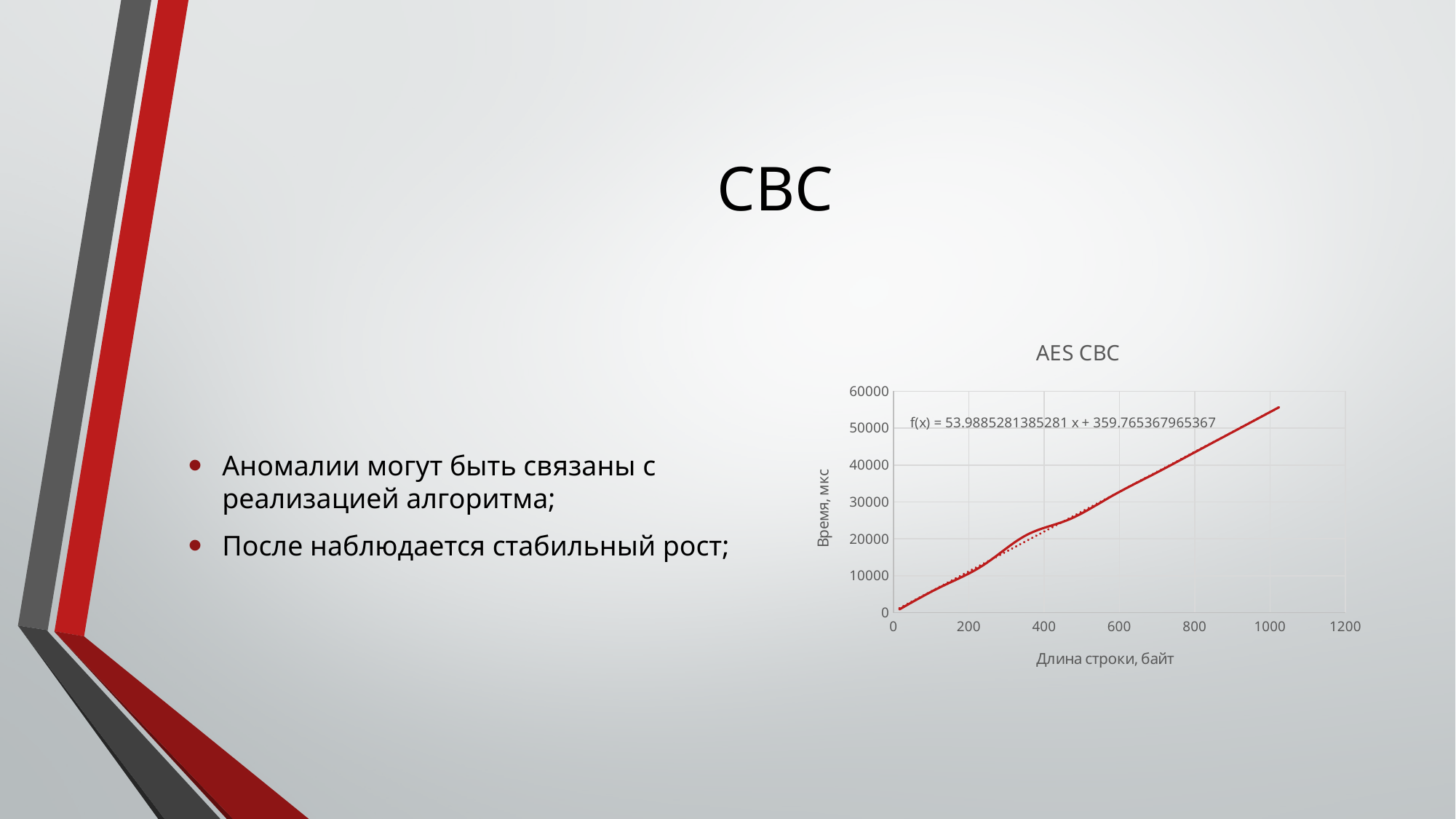
What is the maximum value shown on the x axis of the chart? 1200 Is the value at a string length of 800 bytes greater or less than 40000? greater What is the title of the chart? AES CBC What is the label of the x axis of the chart? Длина строки, байт What kind of chart is shown on the slide? line chart Is the value at a string length of 600 bytes greater or less than 30000? greater Is the value at a string length of 400 bytes greater or less than 30000? less Do the values in the chart rise or fall as the string length increases along the x axis? rise What trendline equation is printed on the chart? f(x) = 53.9885281385281 x + 359.765367965367 What is the maximum value shown on the y axis of the chart? 60000